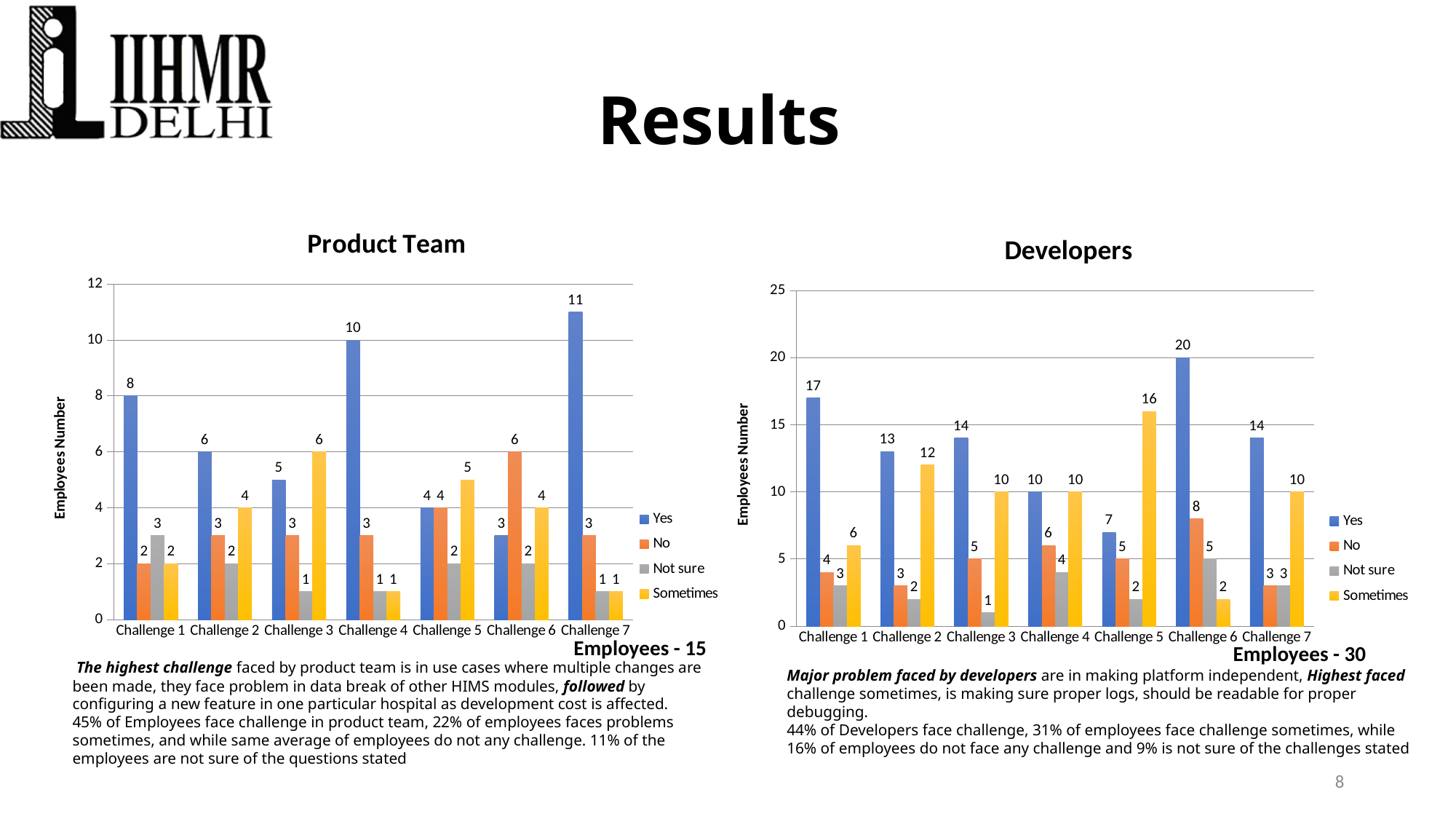
In the Product Team chart, what is the value of the Yes series for Challenge 4? 10 In the Developers chart, what is the Sometimes value for Challenge 5? 16 What kind of chart is the Developers chart? Bar chart In the Product Team chart, how many challenges are shown on the x axis? 7 In the Developers chart, which challenge has the lowest Not sure value? Challenge 3 In the Developers chart, what is the difference between the Yes value for Challenge 1 and the Yes value for Challenge 5? 10 In the Developers chart, which series is shown in yellow according to the legend? Sometimes In the Product Team chart, which challenge has the highest Yes value? Challenge 7 In the Product Team chart, which is larger for Challenge 6: the Yes value or the No value? No In the Developers chart, which challenge has the highest Yes value? Challenge 6 In the Developers chart, how many series does the legend list? 4 In the Product Team chart, what is the difference between the Sometimes value and the Yes value for Challenge 3? 1